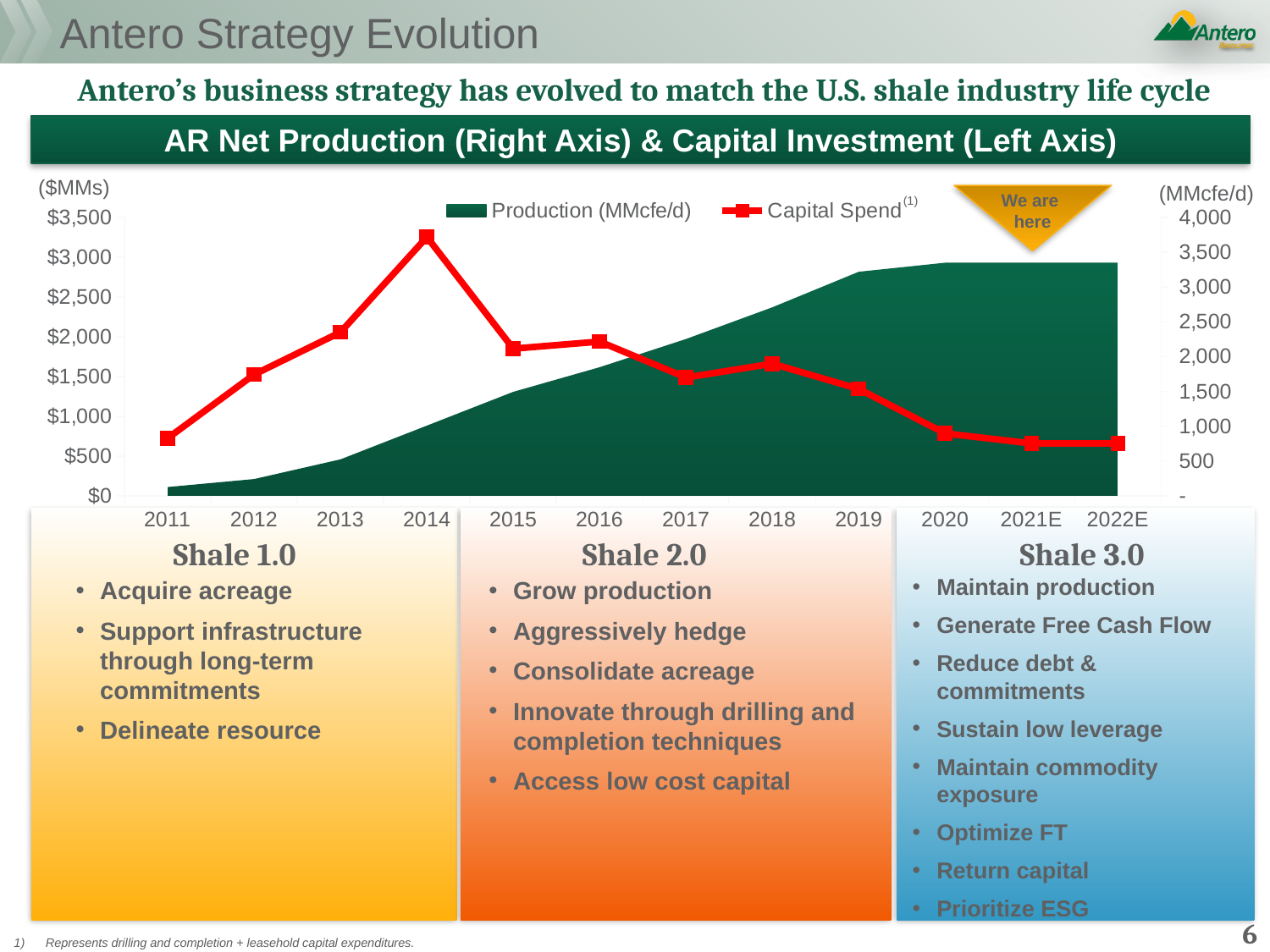
Is the Production value for 2011 greater or less than 500 MMcfe/d? less Is the Capital Spend value for 2020 greater or less than $1,000? less Which year has the larger Capital Spend, 2014 or 2019? 2014 How many years are shown along the x axis of the chart? 12 How many series does the chart legend list? 2 What is the title of the chart? AR Net Production (Right Axis) & Capital Investment (Left Axis) Is the Capital Spend value for 2011 greater or less than $1,000? less In which year is Capital Spend highest? 2014 Does Production rise or fall from 2011 to 2022E? rise What kind of chart is used to show Production and Capital Spend? A combination area and line chart